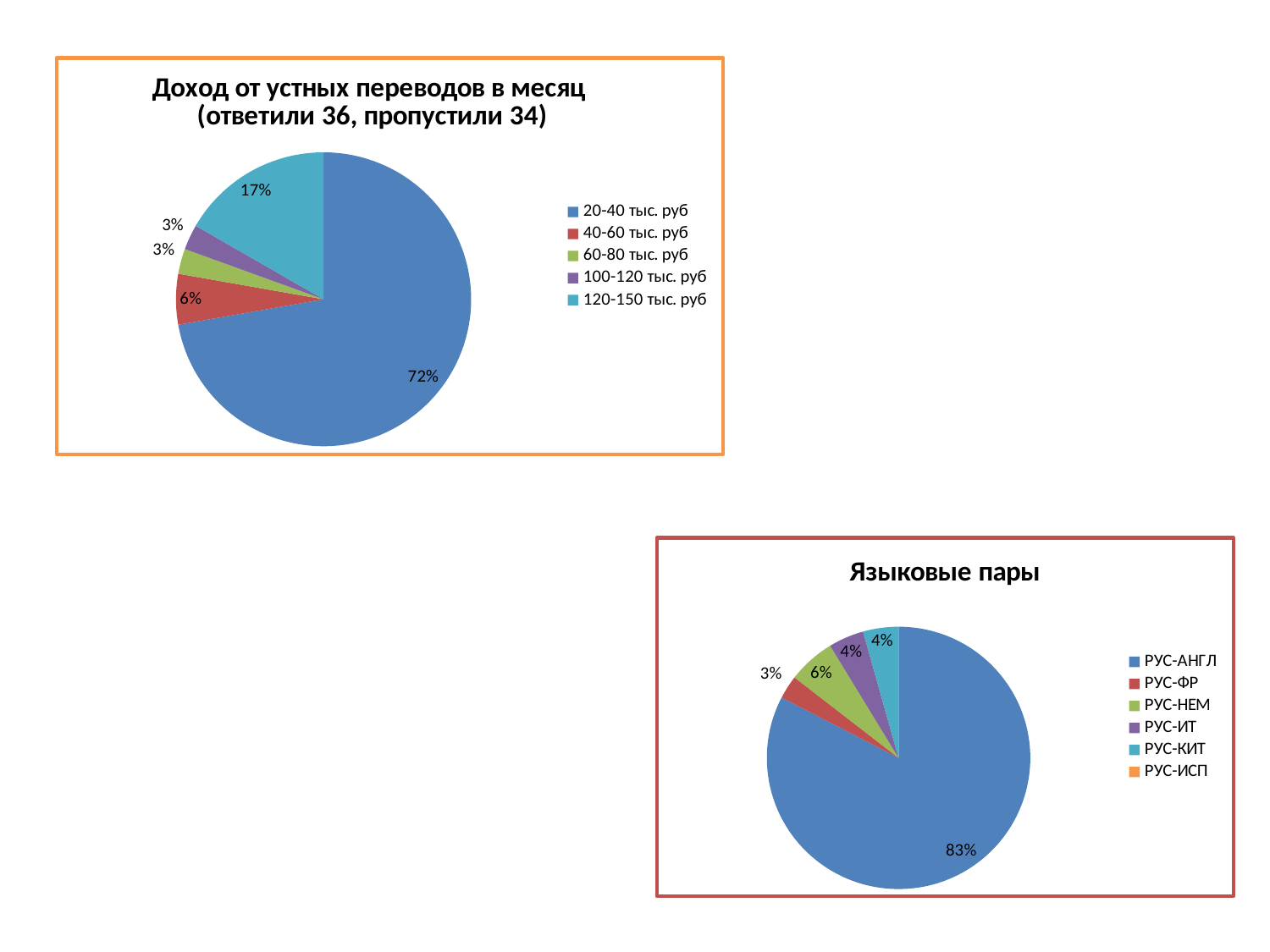
In the chart titled "Доход от устных переводов в месяц", what share of respondents earn 120-150 тыс. руб? 17% In the chart titled "Языковые пары", what share does РУС-НЕМ have? 6% In the chart titled "Языковые пары", what colour is the РУС-АНГЛ slice? Blue In the chart titled "Доход от устных переводов в месяц", how many categories does the legend list? 5 In the chart titled "Доход от устных переводов в месяц", what share of respondents earn 20-40 тыс. руб? 72% What kind of chart is the chart titled "Языковые пары"? Pie chart In the chart titled "Языковые пары", what share does РУС-АНГЛ have? 83% In the chart titled "Языковые пары", how many entries does the legend list? 6 In the chart titled "Доход от устных переводов в месяц", which income category has the largest share? 20-40 тыс. руб In the chart titled "Языковые пары", which is larger, the share for РУС-НЕМ or the share for РУС-ФР? РУС-НЕМ In the chart titled "Доход от устных переводов в месяц", what share of respondents earn 40-60 тыс. руб? 6% In the chart titled "Доход от устных переводов в месяц", what is the difference between the shares for 20-40 тыс. руб and 120-150 тыс. руб? 55%